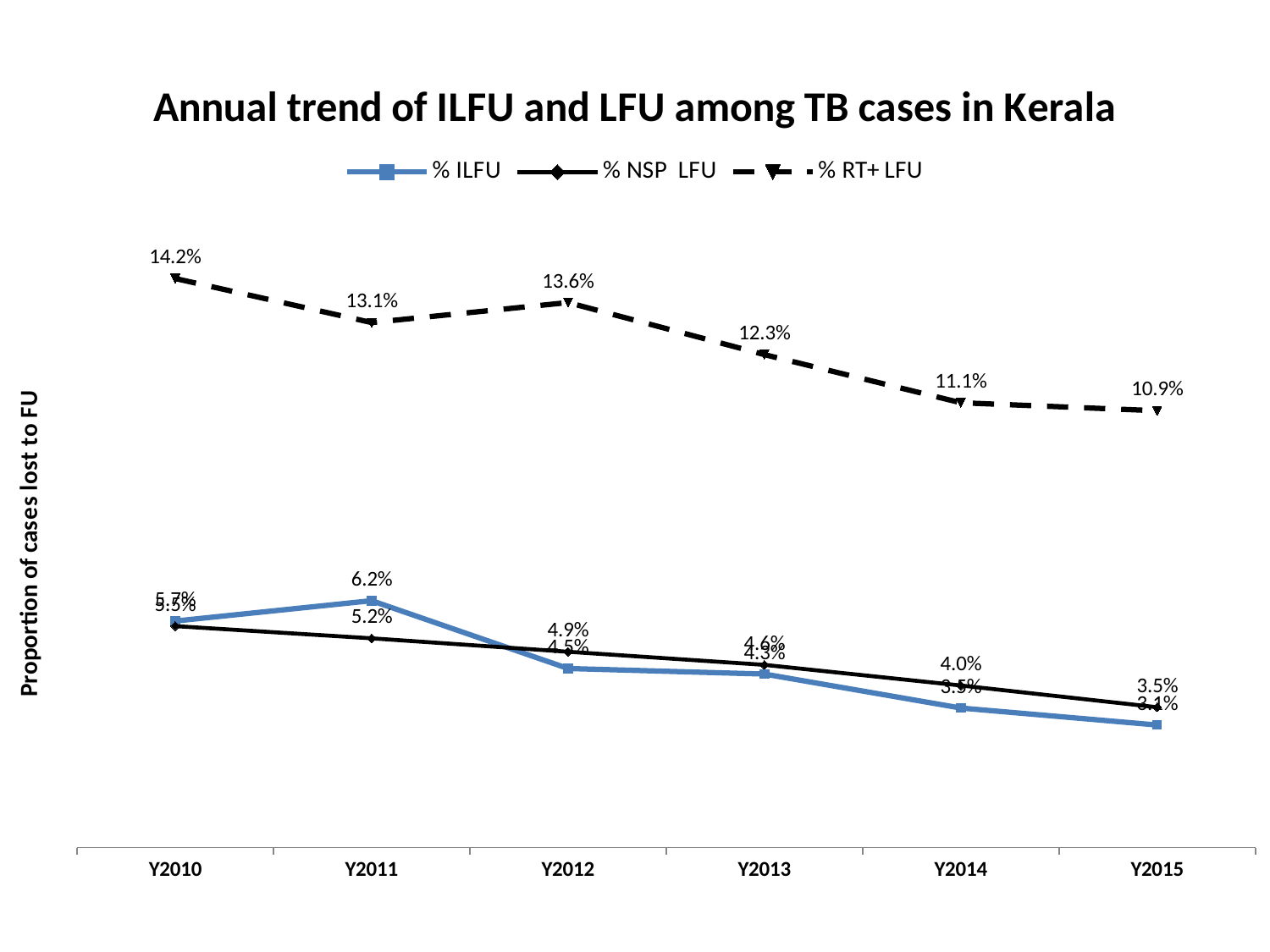
In which year is % ILFU highest? Y2011 What is the value of % RT+ LFU in Y2015? 10.9% What kind of chart is shown on the slide? Line chart What is the value of % ILFU in Y2011? 6.2% In which year is % RT+ LFU highest? Y2010 In which year is % RT+ LFU lowest? Y2015 What is the difference between % RT+ LFU in Y2010 and in Y2015? 3.3 percentage points How many series does the legend list? 3 What is the value of % NSP LFU in Y2012? 4.9% What is the value of % RT+ LFU in Y2010? 14.2% In Y2011, which is larger: % ILFU or % NSP LFU? % ILFU How many years are shown on the x axis? 6